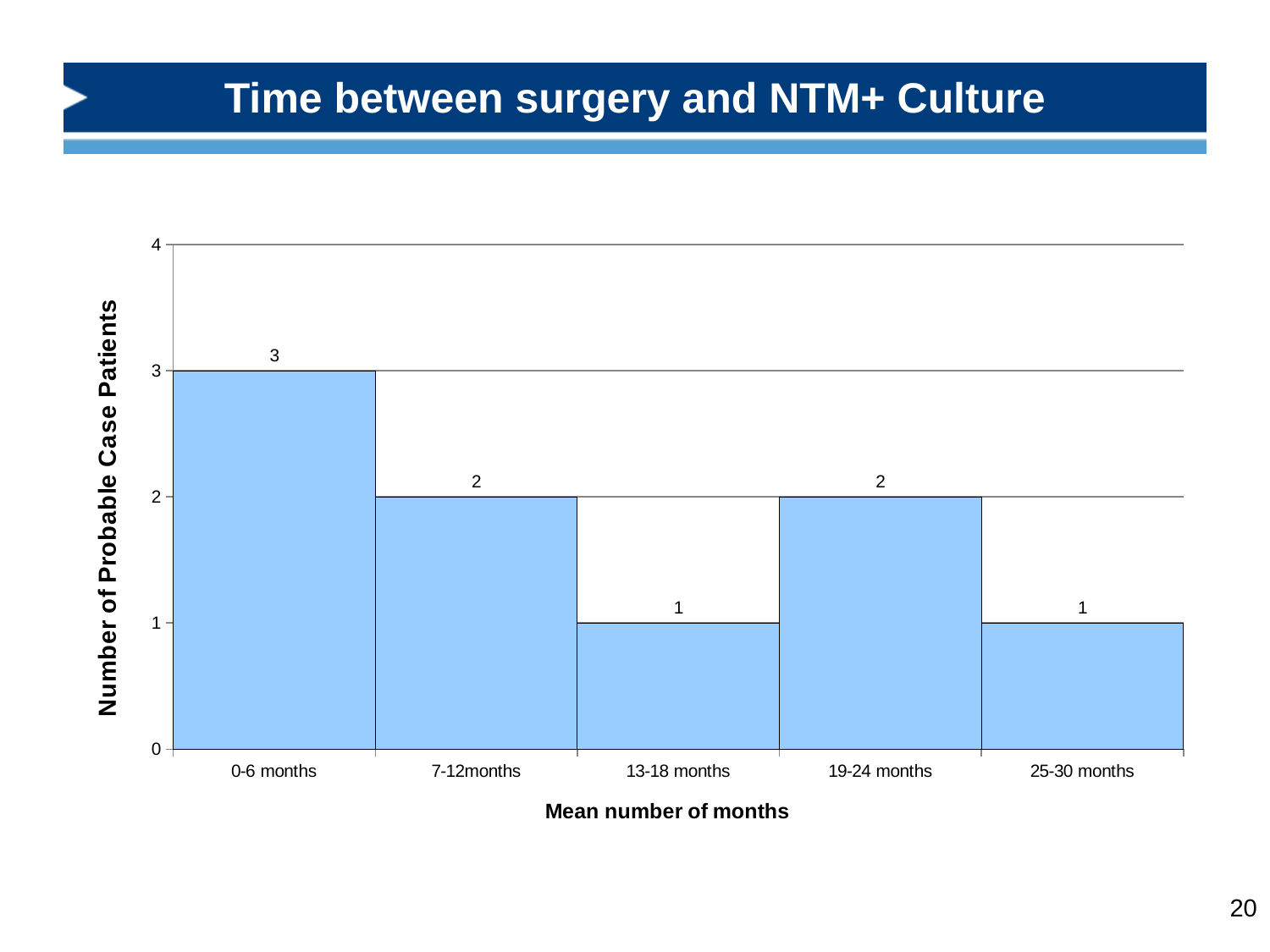
How many probable case patients are in the 0-6 months category? 3 Which category has the highest number of probable case patients? 0-6 months Is the value for 0-6 months greater or less than 2? greater What is the title of the slide? Time between surgery and NTM+ Culture What is the value for the 25-30 months category? 1 Which is larger, the value for 7-12 months or the value for 25-30 months? 7-12 months What is the number of probable case patients for 19-24 months? 2 What is the label of the y axis? Number of Probable Case Patients What kind of chart is shown on the slide? Bar chart How many categories are shown on the x axis? 5 What is the difference between the values for 0-6 months and 13-18 months? 2 What is the total number of probable case patients across all five categories? 9